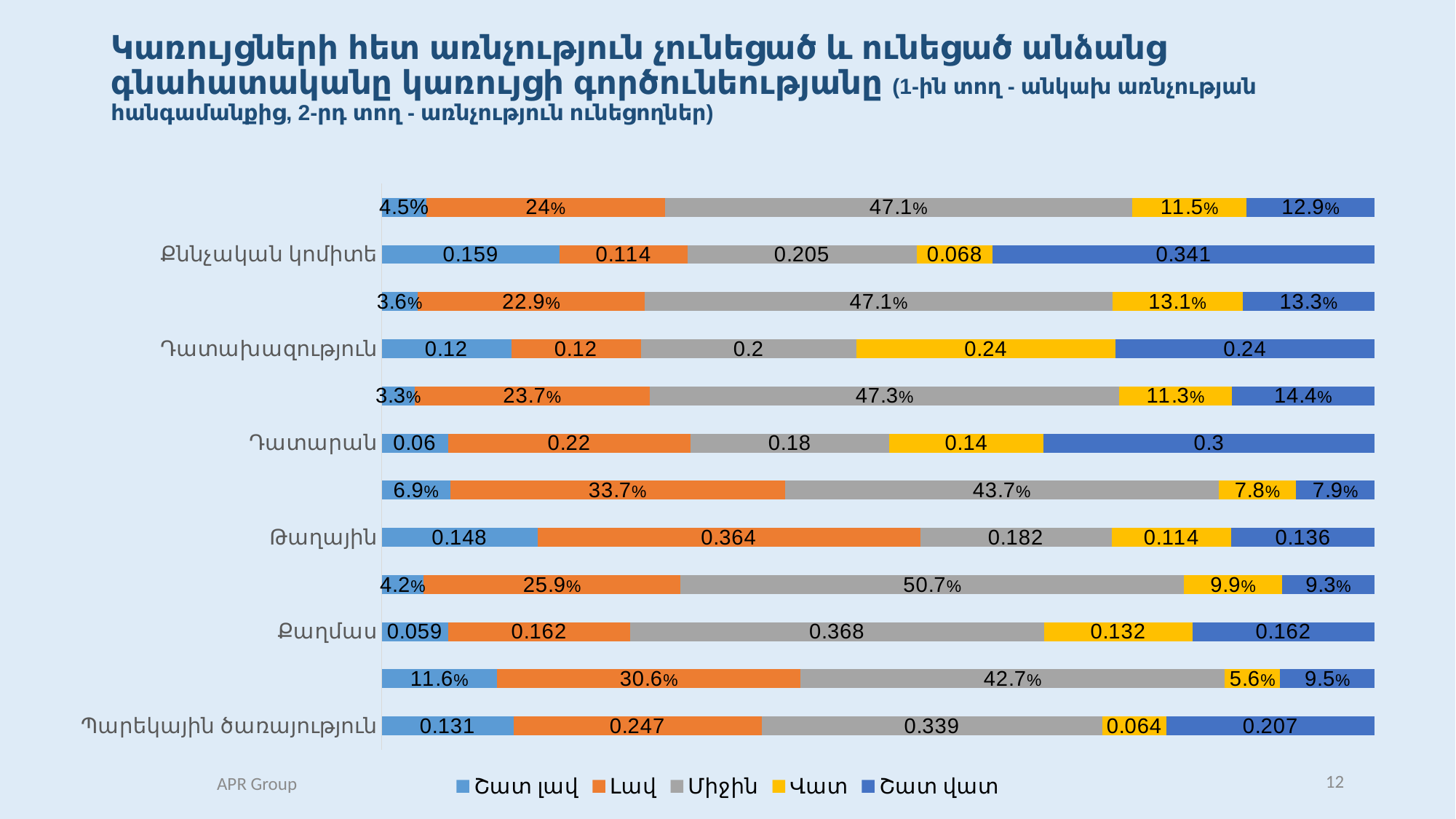
In the second row (had contact) for Քննչական կոմիտե, what is the value for Շատ վատ? 0.341 In the second row (had contact) for Դատարան, which is larger: the Շատ վատ value or the Լավ value? Շատ վատ Among the second rows (had contact), which institution has the lowest Շատ լավ value? Քաղմաս Among the first rows (no contact), which institution has the highest Միջին value? Քաղմաս In the first row (no contact) for Պարեկային ծառայություն, what is the value for Շատ լավ? 11.6% In the first row (no contact) for Քննչական կոմիտե, what is the value for Միջին? 47.1% How many series does the legend list? 5 How many institutions (category labels) are shown on the vertical axis? 6 What kind of chart is shown on the slide? Stacked bar chart Which legend entry is shown in yellow? Վատ In the second row (had contact) for Թաղային, what is the value for Լավ? 0.364 In the first row (no contact) for Դատարան, what is the difference between the Միջին value and the Լավ value? 23.6%